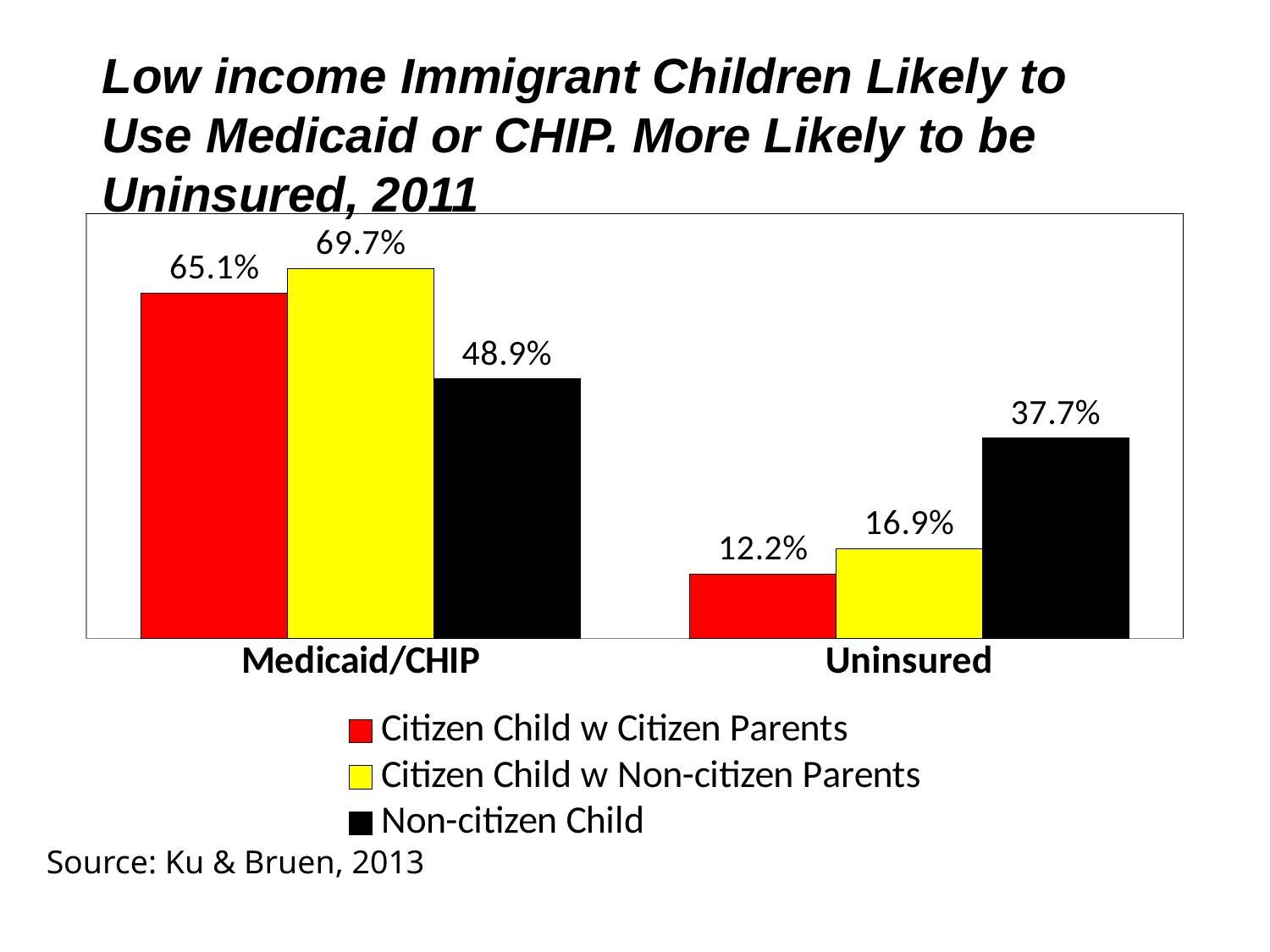
What is the Medicaid/CHIP value for Citizen Child w Non-citizen Parents? 69.7% Which series has the highest value in the Medicaid/CHIP category? Citizen Child w Non-citizen Parents How many categories are shown on the x axis? 2 What is the Uninsured value for Citizen Child w Citizen Parents? 12.2% What is the Medicaid/CHIP value for Citizen Child w Citizen Parents? 65.1% What is the difference between the Medicaid/CHIP values for Citizen Child w Non-citizen Parents and Non-citizen Child? 20.8% Which is larger: the Uninsured value for Non-citizen Child or the Uninsured value for Citizen Child w Non-citizen Parents? Non-citizen Child Which series has the lowest value in the Uninsured category? Citizen Child w Citizen Parents What is the difference between the Uninsured values for Non-citizen Child and Citizen Child w Non-citizen Parents? 20.8% How many series does the legend list? 3 What is the Uninsured value for Non-citizen Child? 37.7% What kind of chart is shown on the slide? Bar chart